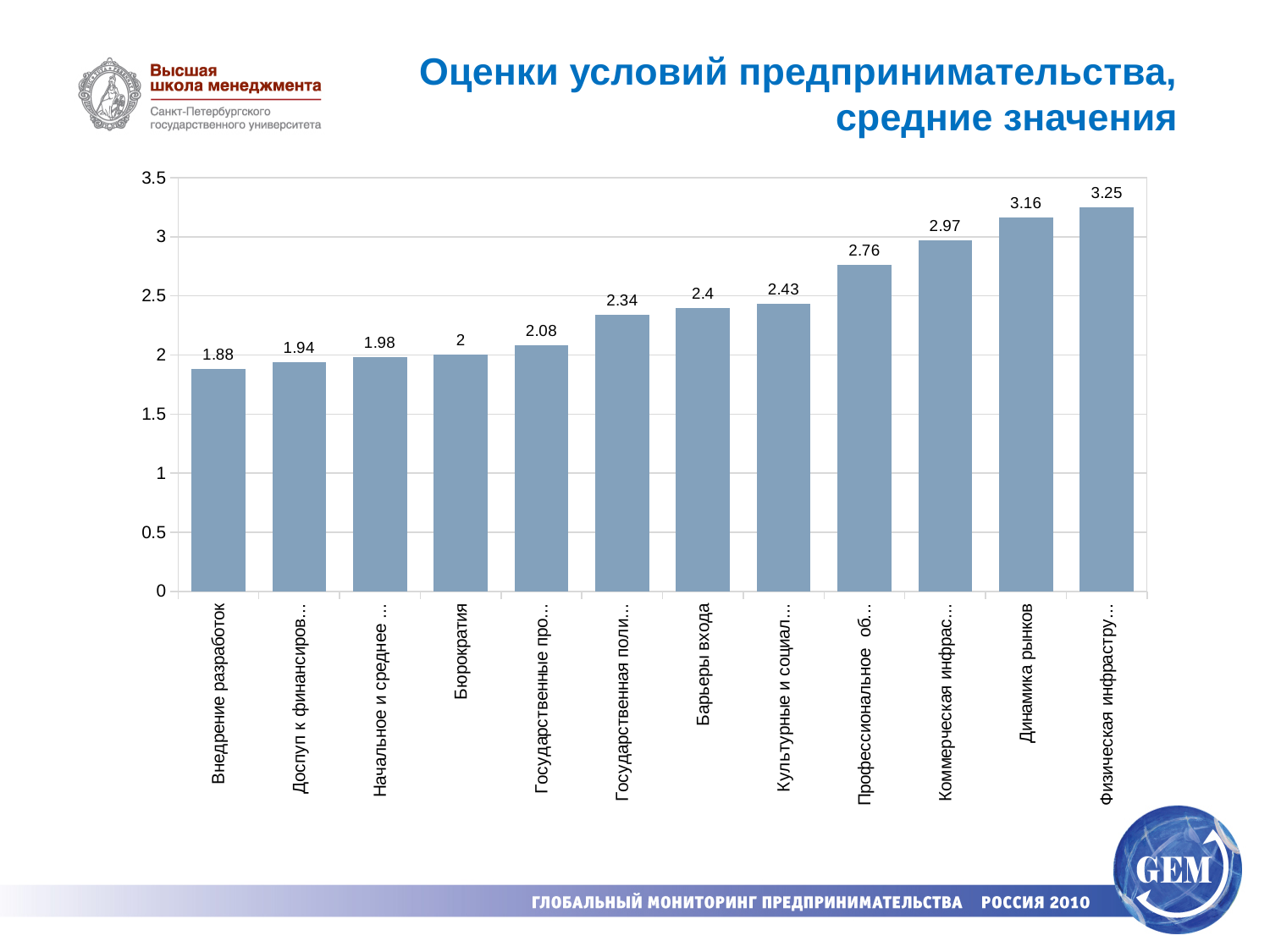
Do the values rise or fall from left to right along the x axis? rise How many bars (categories) does the chart show? 12 What is the value for Динамика рынков? 3.16 Which is larger, the value for Бюрократия or the value for Барьеры входа? Барьеры входа What kind of chart is shown on the slide? bar chart What is the title of the slide? Оценки условий предпринимательства, средние значения What is the difference between the values for Динамика рынков and Барьеры входа? 0.76 What is the value of the rightmost bar in the chart? 3.25 Which category has the lowest value? Внедрение разработок What is the value for Внедрение разработок? 1.88 What is the value for Бюрократия? 2 What is the value for Барьеры входа? 2.4